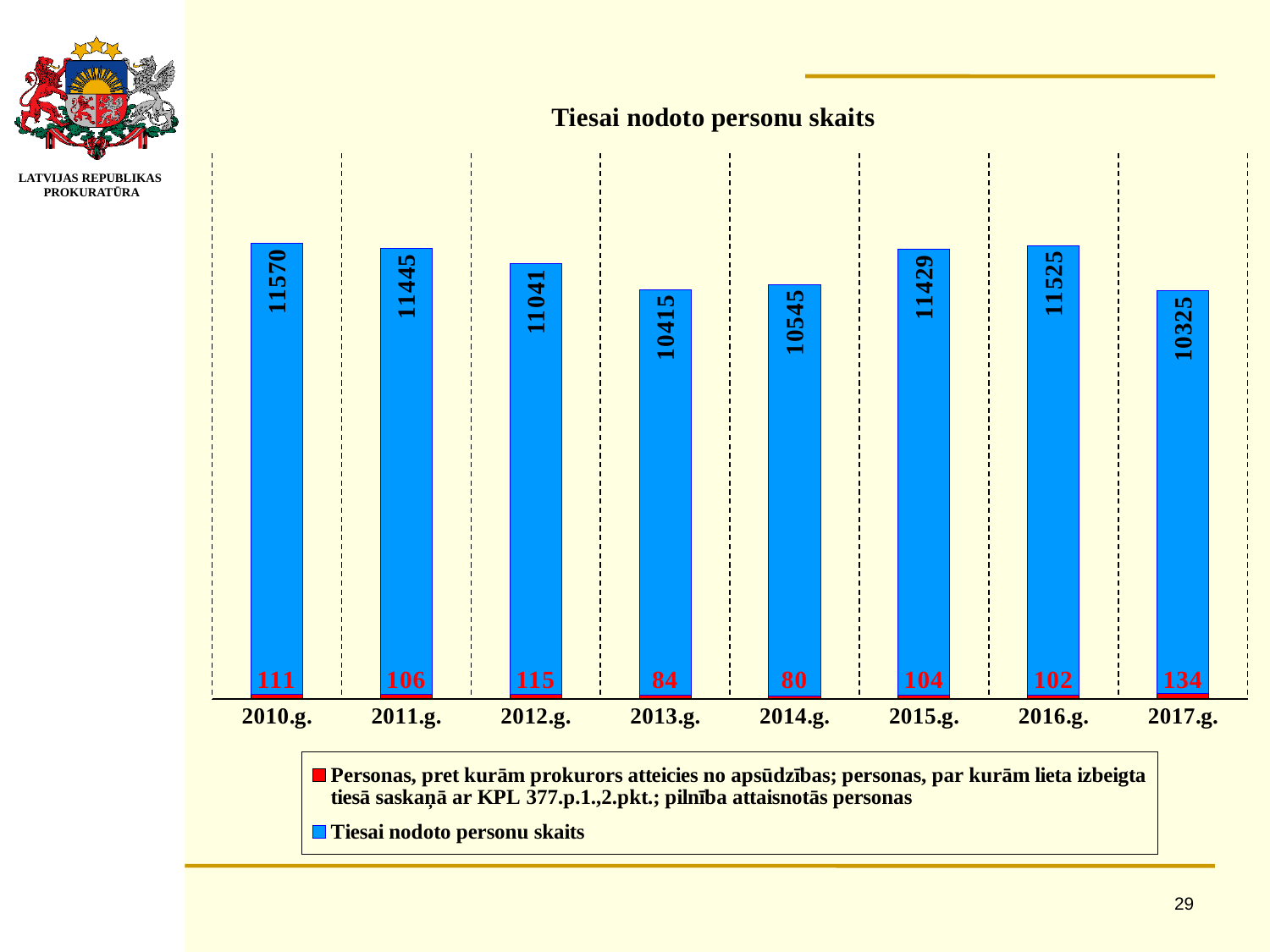
Which is larger, the "Tiesai nodoto personu skaits" value for 2013.g. or for 2015.g.? 2015.g. What kind of chart is shown on the slide? Bar chart What is the value of the red series (Personas, pret kurām prokurors atteicies no apsūdzības...) for 2017.g.? 134 What is the value of "Tiesai nodoto personu skaits" for 2014.g.? 10545 Which year has the highest value of "Tiesai nodoto personu skaits"? 2010.g. Which year has the lowest value of "Tiesai nodoto personu skaits"? 2017.g. What is the title of the chart? Tiesai nodoto personu skaits What is the difference between the "Tiesai nodoto personu skaits" values for 2016.g. and 2017.g.? 1200 Which year has the lowest value of the red series (Personas, pret kurām prokurors atteicies no apsūdzības...)? 2014.g. How many years are shown on the x axis of the chart? 8 What is the value of "Tiesai nodoto personu skaits" for 2010.g.? 11570 How many series does the legend list? 2